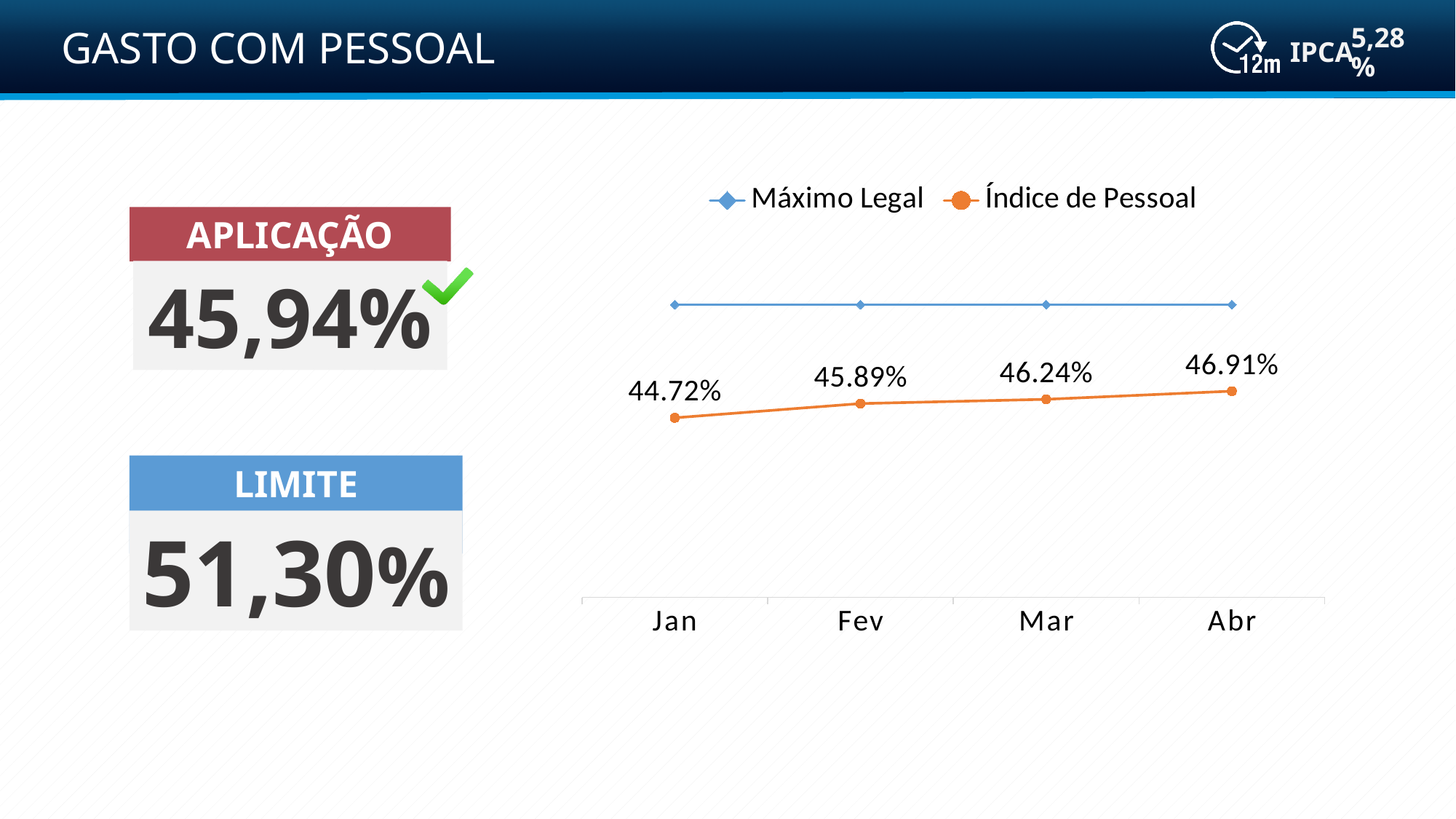
What type of chart is shown on the slide? Line chart Does Índice de Pessoal rise or fall from Jan to Abr? Rise By how many percentage points does Índice de Pessoal increase from Jan to Abr? 2.19 How many months are shown on the x axis of the chart? 4 Which series has the higher values in the chart, Máximo Legal or Índice de Pessoal? Máximo Legal In which month is Índice de Pessoal highest? Abr In which month is Índice de Pessoal lowest? Jan What is the value of Índice de Pessoal in Fev? 45.89% How many series does the chart legend list? 2 What is the value of Índice de Pessoal in Mar? 46.24% What is the value of Índice de Pessoal in Abr? 46.91% What is the value of Índice de Pessoal in Jan? 44.72%